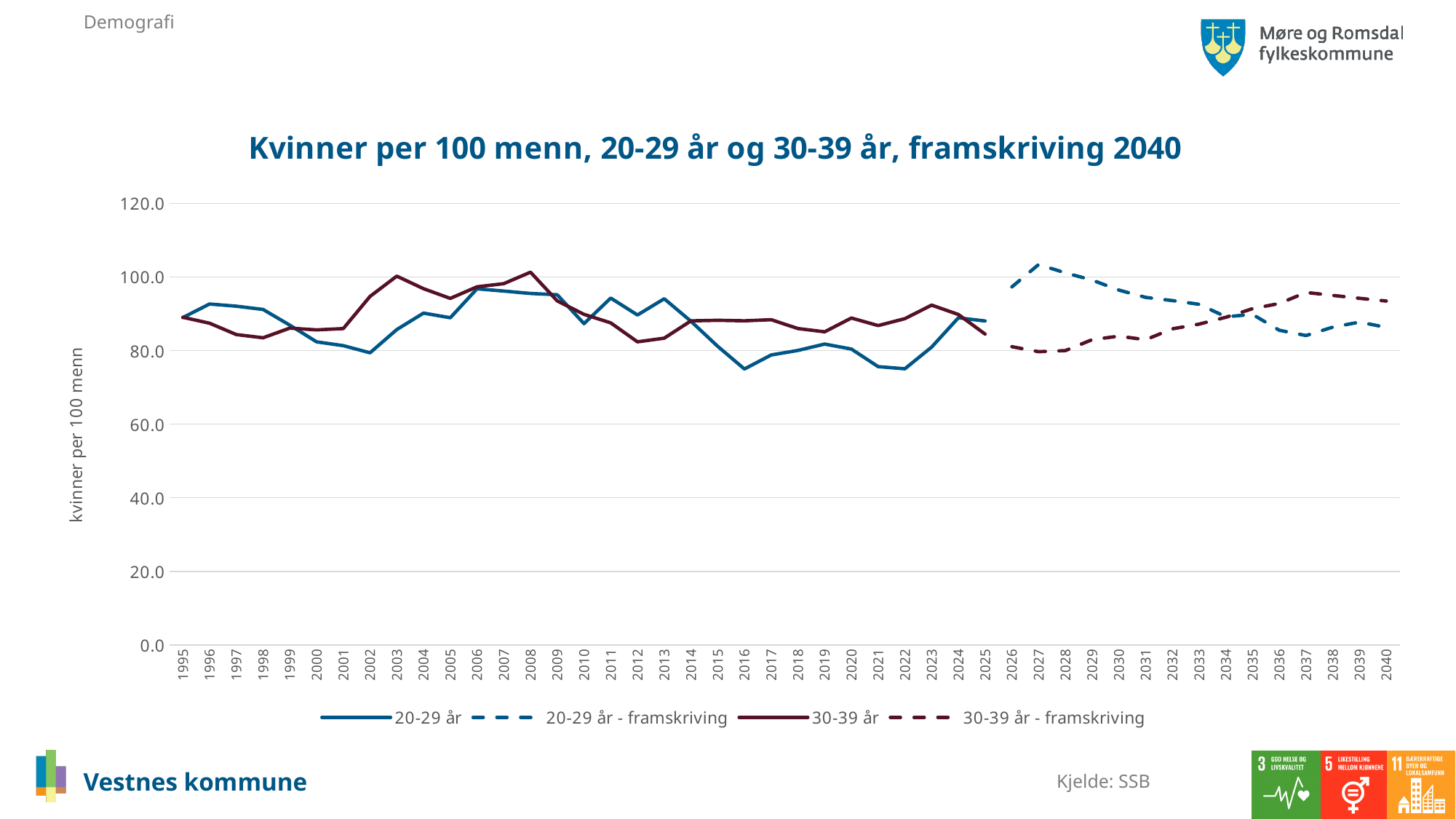
How many series does the legend list? 4 Is the value for 20-29 år in 2016 greater or less than 80? less In 2027, which projection is higher, 20-29 år - framskriving or 30-39 år - framskriving? 20-29 år - framskriving Does the 20-29 år line rise or fall from 2013 to 2016? fall Is the value for 20-29 år - framskriving in 2027 greater or less than 100? greater What is the title of the chart? Kvinner per 100 menn, 20-29 år og 30-39 år, framskriving 2040 In 2016, which series has the higher value, 20-29 år or 30-39 år? 30-39 år What is the label on the vertical axis? kvinner per 100 menn Is the value for 30-39 år in 2008 greater or less than 100? greater What type of chart is shown on the slide? line chart Does the 30-39 år - framskriving line rise or fall from 2027 to 2037? rise